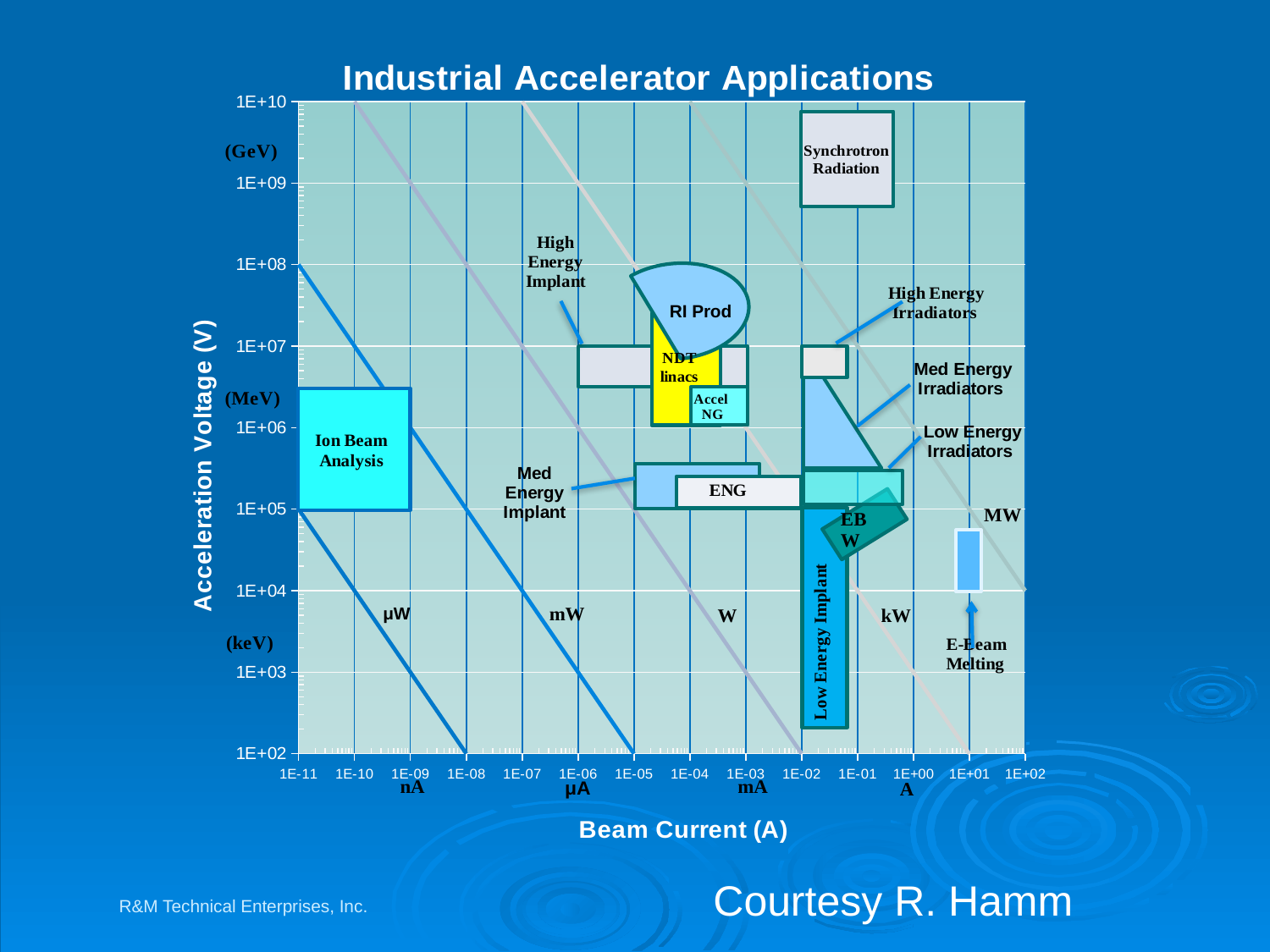
Is the acceleration voltage of the Low Energy Implant region greater or less than 1E+06 V? less Which region operates at a higher acceleration voltage, High Energy Implant or Med Energy Implant? High Energy Implant Which application region reaches the highest acceleration voltage on the chart? Synchrotron Radiation Is the beam current of the Ion Beam Analysis region greater or less than 1E-07 A? less Is the acceleration voltage of the Synchrotron Radiation region greater or less than 1E+08 V? greater Which application region sits at the lowest beam current on the chart? Ion Beam Analysis How many constant-power diagonal lines (µW, mW, W, kW, MW) are labelled on the chart? 5 Which application region extends to the lowest acceleration voltage on the chart? Low Energy Implant What is the title of the chart? Industrial Accelerator Applications Which region operates at a higher beam current, Ion Beam Analysis or Low Energy Implant? Low Energy Implant What is the label of the vertical axis? Acceleration Voltage (V)